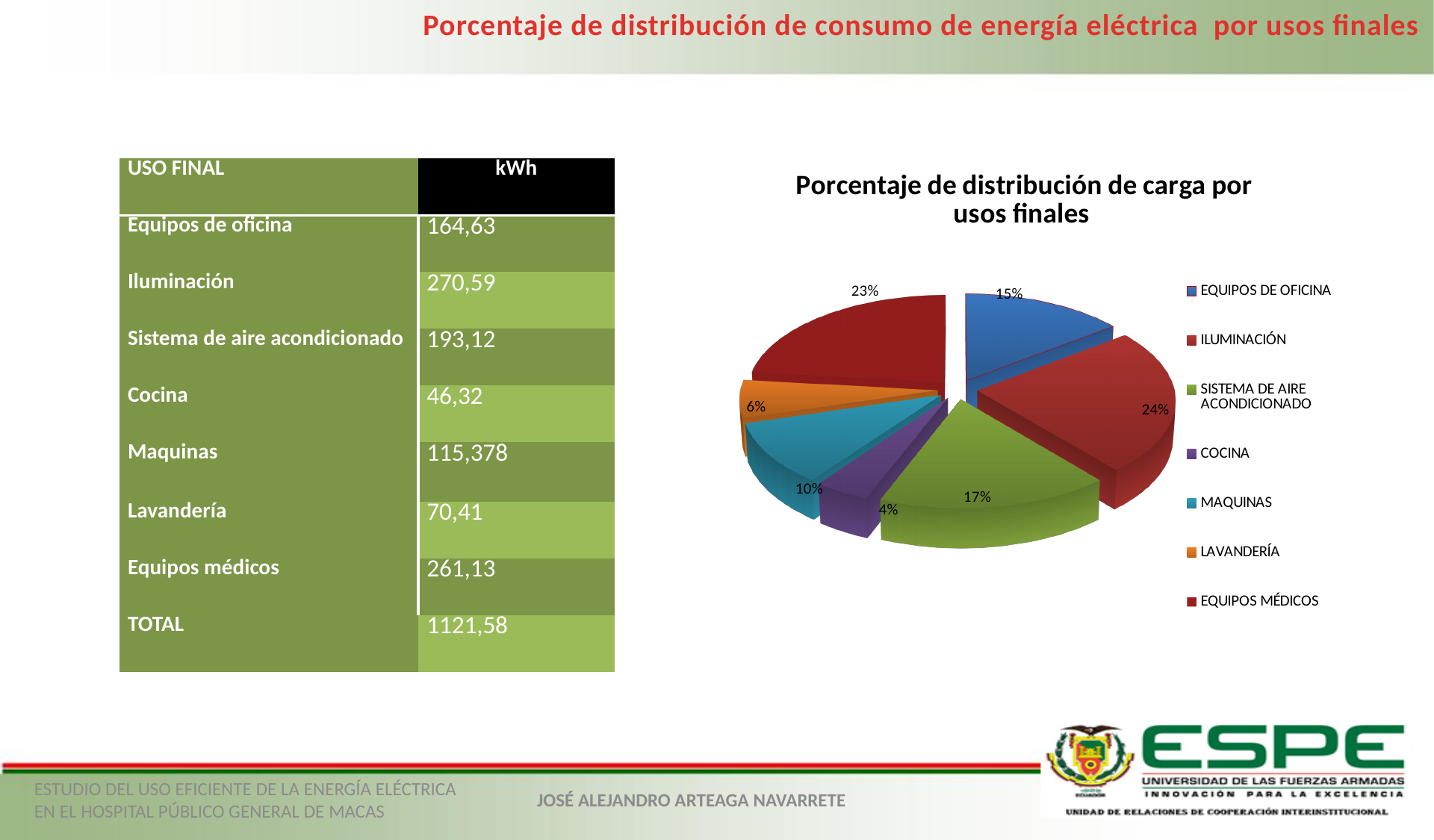
What share of the pie does EQUIPOS MÉDICOS have? 23% Which category has the smallest slice of the pie? COCINA What share of the pie does ILUMINACIÓN have? 24% What share of the pie does MAQUINAS have? 10% Which category has the largest slice of the pie? ILUMINACIÓN What colour is the EQUIPOS DE OFICINA slice in the pie chart? Blue What type of chart is shown on the slide? Pie chart How many categories does the legend of the pie chart list? 7 What is the difference in percentage points between the SISTEMA DE AIRE ACONDICIONADO slice and the LAVANDERÍA slice? 11 Which slice is larger, EQUIPOS DE OFICINA or MAQUINAS? EQUIPOS DE OFICINA What is the title of the pie chart? Porcentaje de distribución de carga por usos finales